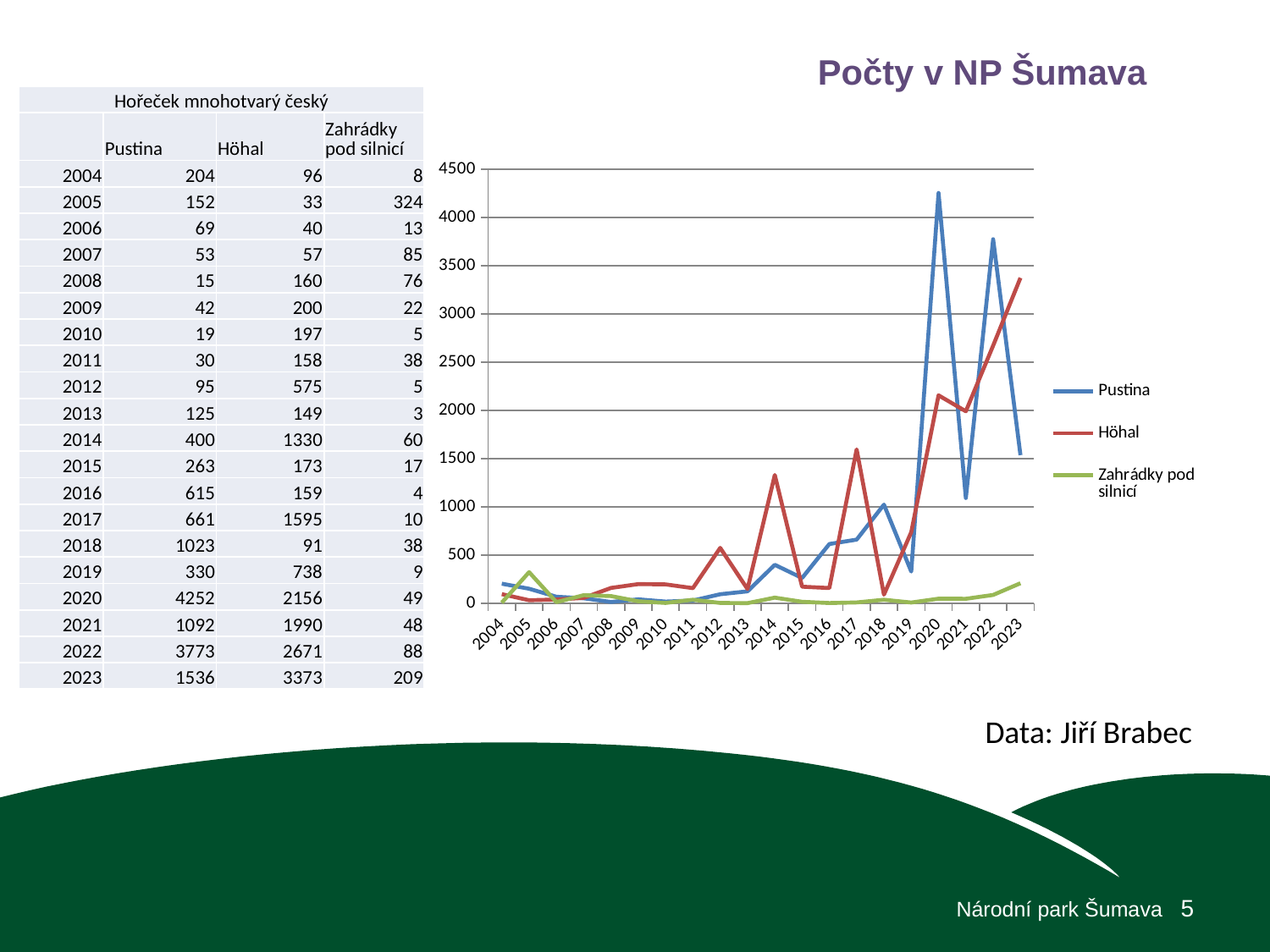
Which series has the larger value in 2022, Pustina or Höhal? Pustina How many series does the chart legend list? 3 In which year does the Pustina series reach its highest value? 2020 In which year is the Pustina value lowest? 2008 What is the value for Zahrádky pod silnicí in 2005? 324 In which year does the Höhal series reach its highest value? 2023 How many years are plotted along the x axis of the chart? 20 What kind of chart is shown on the slide? line chart Is the value for Pustina in 2020 greater or less than 4000? greater What is the difference between the Pustina and Höhal values in 2020? 2096 What is the value for Pustina in 2020? 4252 What is the value for Höhal in 2014? 1330